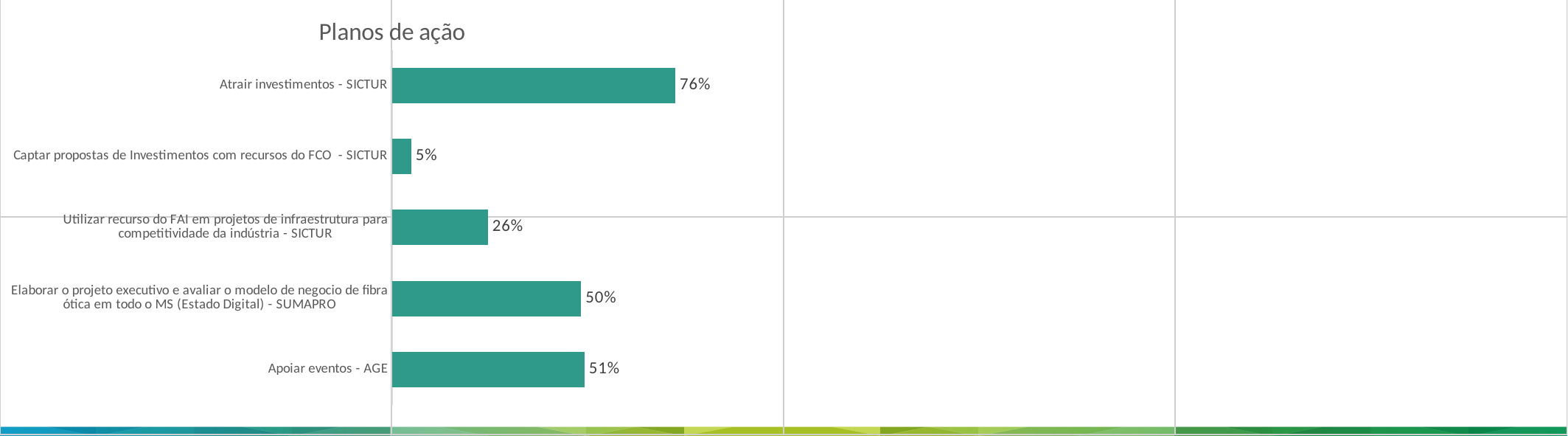
How many categories are shown in the chart? 5 What is the value for "Atrair investimentos - SICTUR"? 76% What is the difference between the values for "Atrair investimentos - SICTUR" and "Apoiar eventos - AGE"? 25% What is the difference between the values for "Utilizar recurso do FAI em projetos de infraestrutura para competitividade da indústria - SICTUR" and "Captar propostas de Investimentos com recursos do FCO - SICTUR"? 21% What is the value for "Elaborar o projeto executivo e avaliar o modelo de negocio de fibra ótica em todo o MS (Estado Digital) - SUMAPRO"? 50% What is the value for "Apoiar eventos - AGE"? 51% Which is larger, the value for "Apoiar eventos - AGE" or the value for "Utilizar recurso do FAI em projetos de infraestrutura para competitividade da indústria - SICTUR"? Apoiar eventos - AGE What is the value for "Utilizar recurso do FAI em projetos de infraestrutura para competitividade da indústria - SICTUR"? 26% Which category has the lowest value? Captar propostas de Investimentos com recursos do FCO - SICTUR What kind of chart is shown on the slide? Bar chart What is the value for "Captar propostas de Investimentos com recursos do FCO - SICTUR"? 5% Which category has the highest value? Atrair investimentos - SICTUR